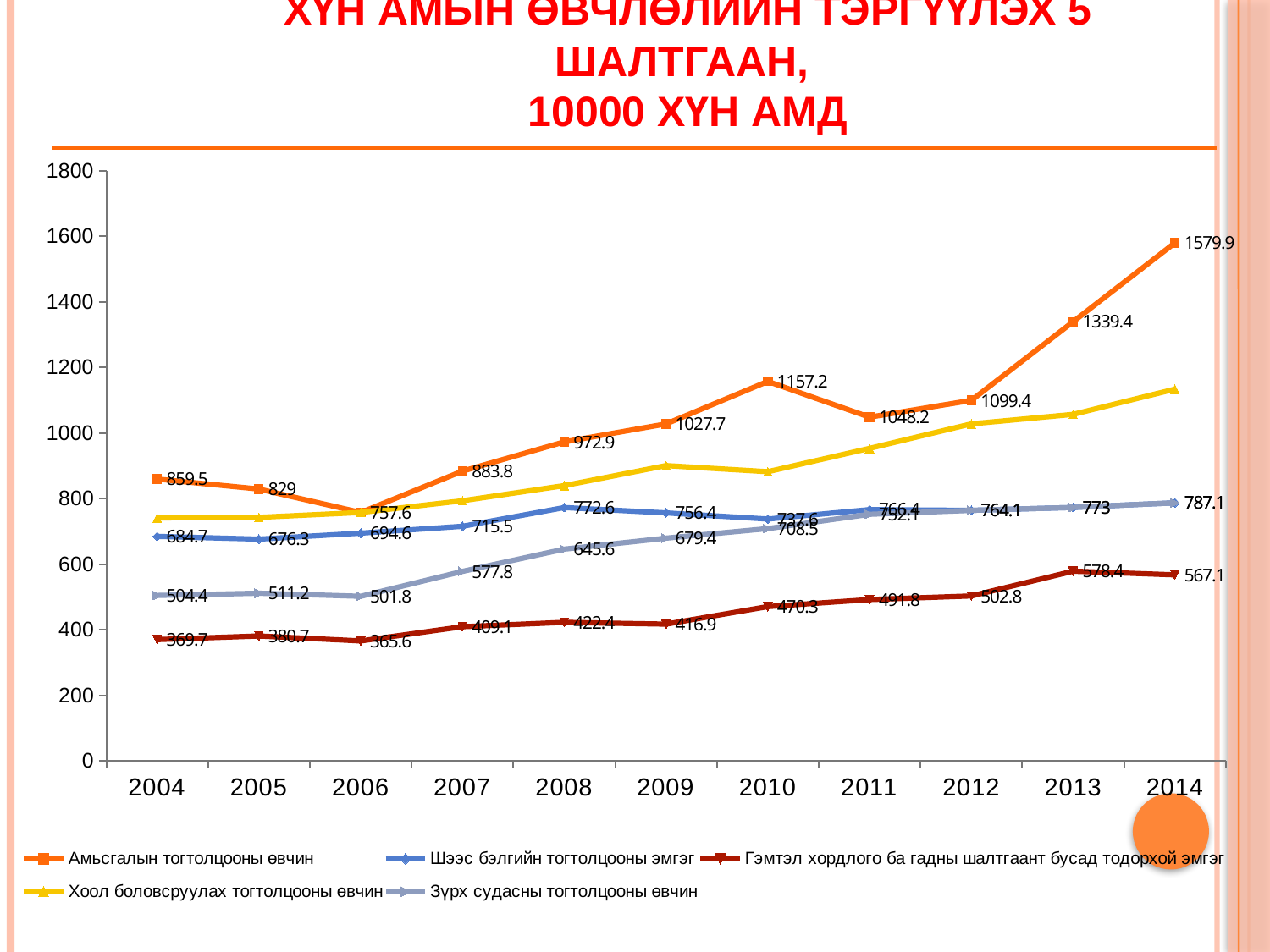
What is the value for Амьсгалын тогтолцооны өвчин in 2010? 1157.2 What is the difference between the 2014 and 2013 values for Амьсгалын тогтолцооны өвчин? 240.5 How many series does the legend list? 5 What type of chart is shown on the slide? line chart Is the value for Хоол боловсруулах тогтолцооны өвчин in 2014 greater or less than 1000? greater Which is larger in 2004: Шээс бэлгийн тогтолцооны эмгэг or Зүрх судасны тогтолцооны өвчин? Шээс бэлгийн тогтолцооны эмгэг In which year is the value for Амьсгалын тогтолцооны өвчин highest? 2014 What is the value for Зүрх судасны тогтолцооны өвчин in 2008? 645.6 What is the value for Амьсгалын тогтолцооны өвчин in 2014? 1579.9 What is the value for Гэмтэл хордлого ба гадны шалтгаант бусад тодорхой эмгэг in 2006? 365.6 In which year is the value for Амьсгалын тогтолцооны өвчин lowest? 2006 How many years are shown on the x axis? 11